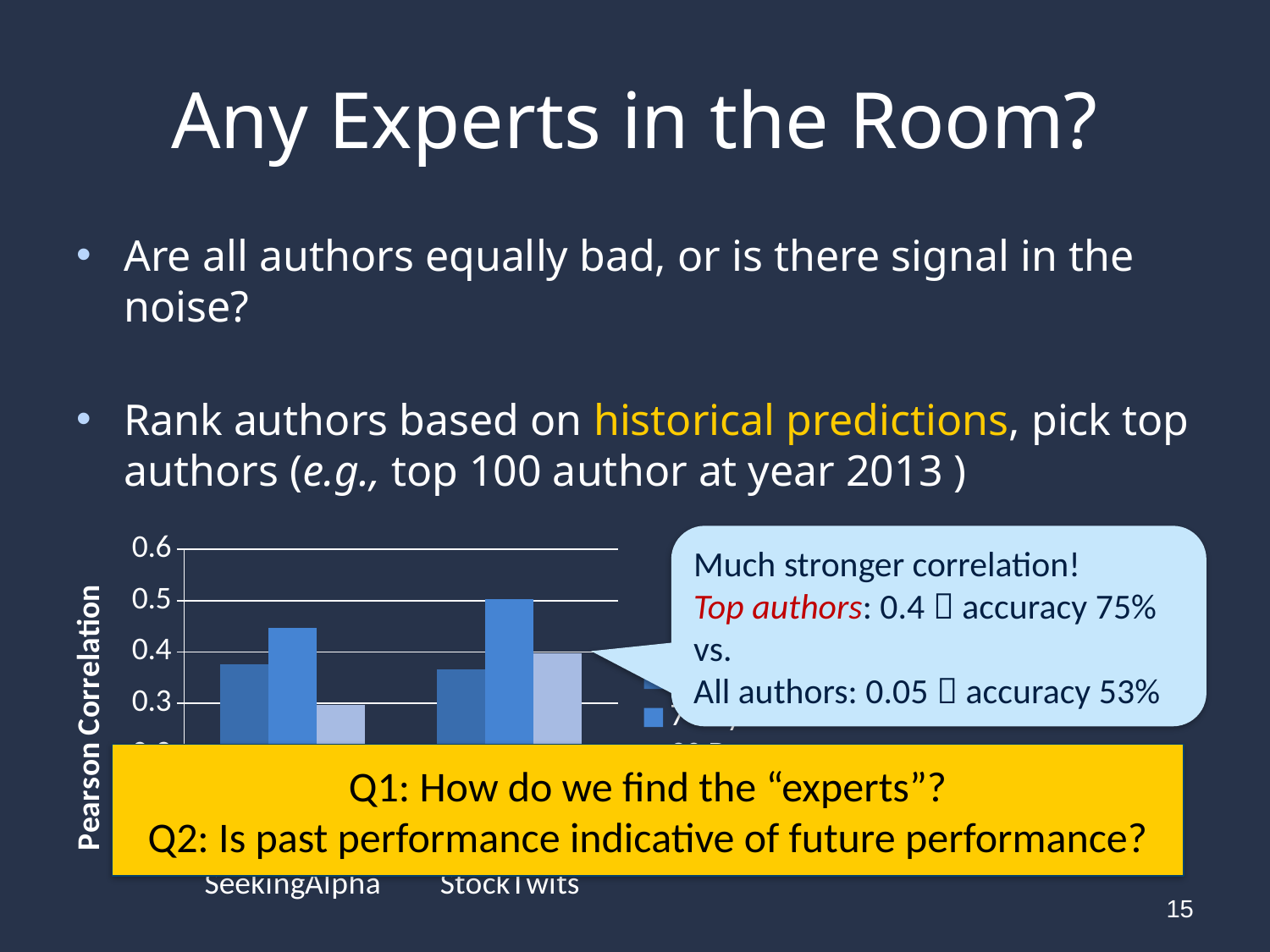
Which category has the taller lightest blue bar, SeekingAlpha or StockTwits? StockTwits What is the highest value shown on the y axis of the chart? 0.6 Is the value of the first (dark blue) bar for StockTwits greater or less than 0.4? less What is the label of the y axis of the chart? Pearson Correlation How many categories are shown on the x axis of the chart? 2 Is the value of the middle (medium blue) bar for SeekingAlpha greater or less than 0.4? greater Is the value of the lightest blue bar for SeekingAlpha greater or less than 0.4? less Within the SeekingAlpha group, which bar is the shortest? the lightest blue (third) bar Which category contains the tallest bar in the chart? StockTwits What kind of chart is shown on the slide? bar chart Which category has the taller middle (medium blue) bar, SeekingAlpha or StockTwits? StockTwits